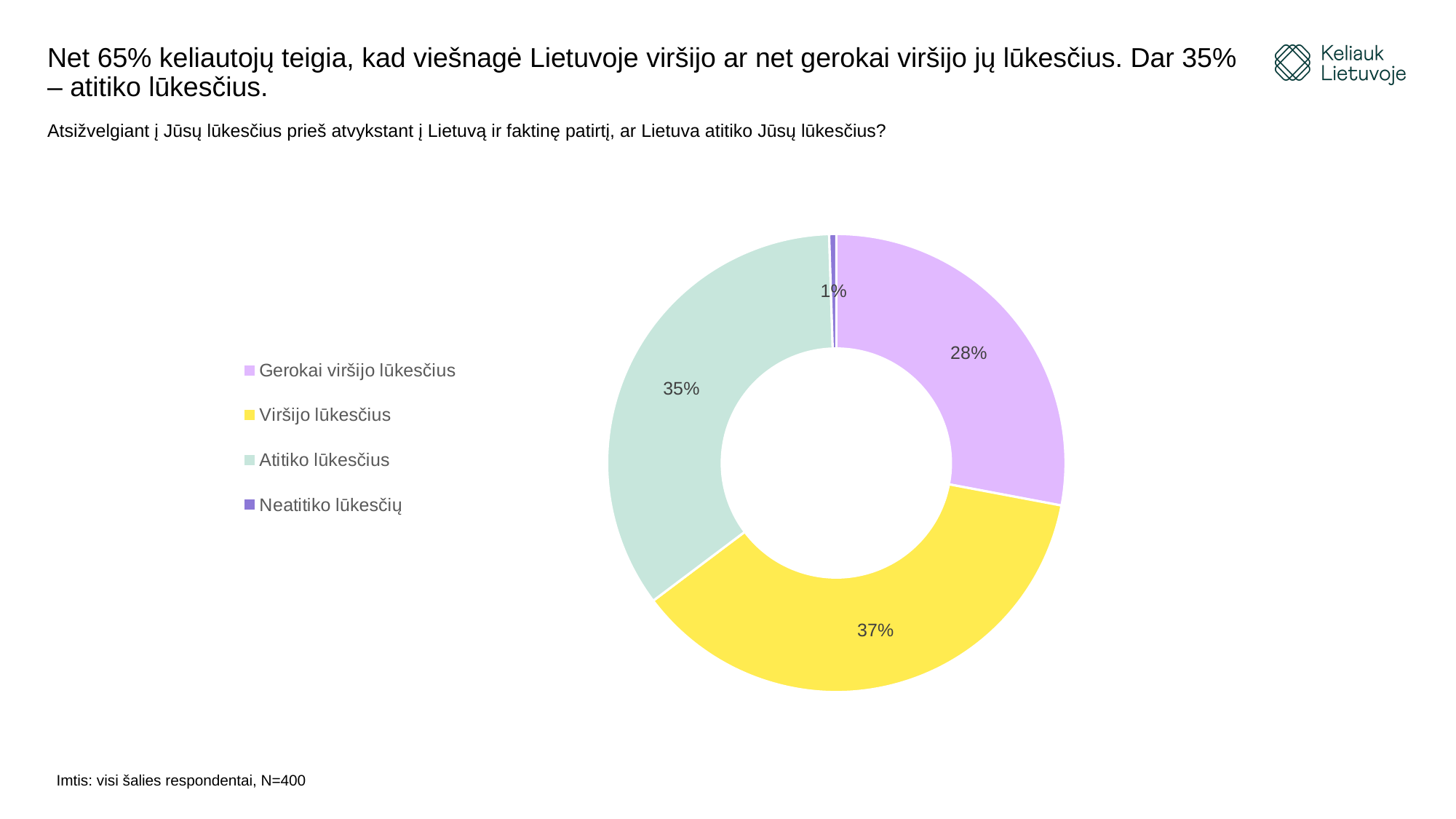
What share of respondents answered "Viršijo lūkesčius"? 37% What share of respondents answered "Neatitiko lūkesčių"? 1% What share of respondents answered "Gerokai viršijo lūkesčius"? 28% What kind of chart is shown on the slide? Pie chart (doughnut) Which is larger: the share for "Atitiko lūkesčius" or the share for "Gerokai viršijo lūkesčius"? Atitiko lūkesčius What share of respondents answered "Atitiko lūkesčius"? 35% What is the combined share of "Gerokai viršijo lūkesčius" and "Viršijo lūkesčius"? 65% How many categories does the chart show? 4 What is the difference in percentage points between "Viršijo lūkesčius" and "Gerokai viršijo lūkesčius"? 9 percentage points Which category has the smallest share of the pie? Neatitiko lūkesčių Which category has the largest share of the pie? Viršijo lūkesčius What colour is the "Atitiko lūkesčius" slice? Light green